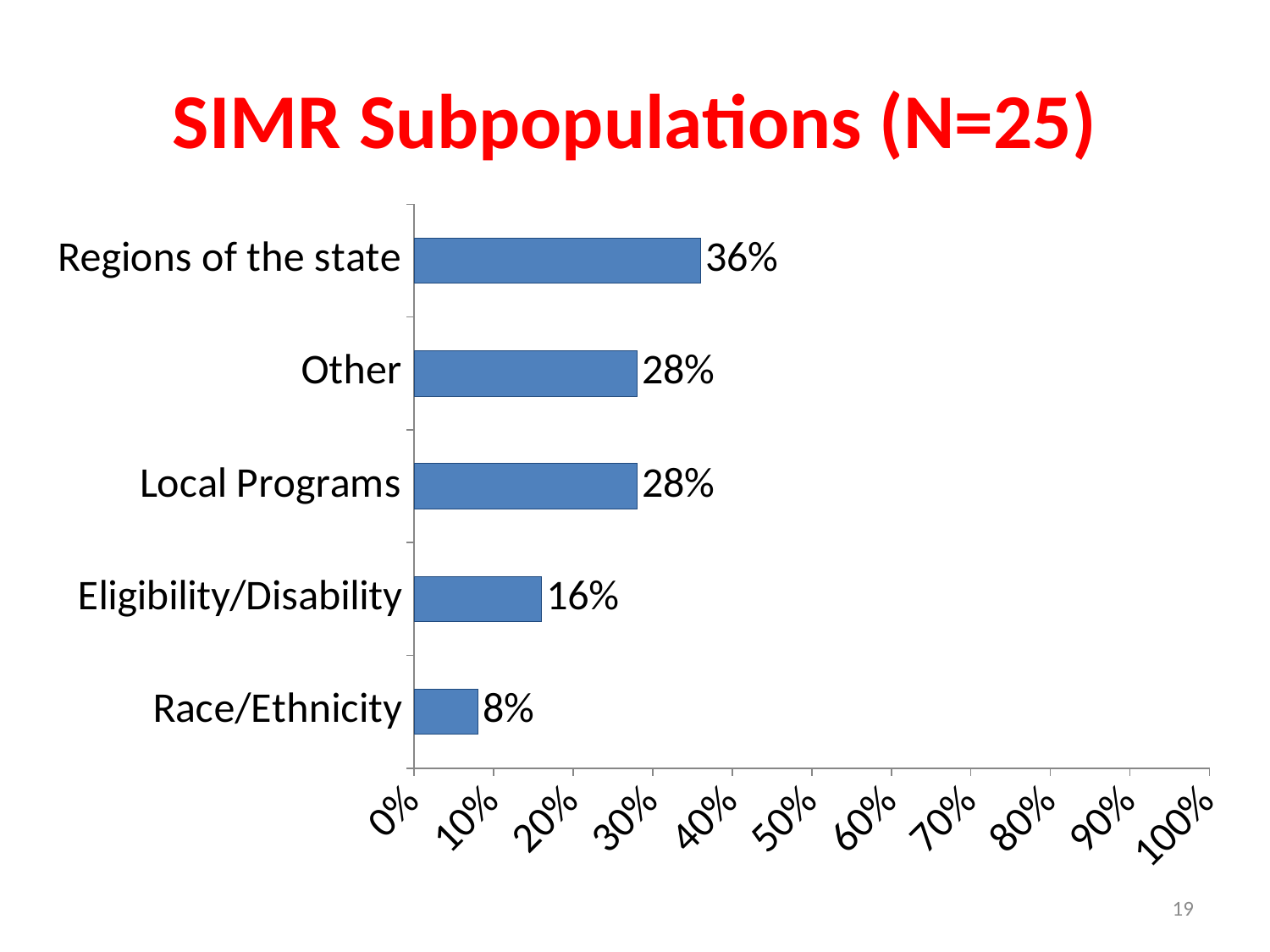
What is the value for Race/Ethnicity? 8% Which category has the highest value? Regions of the state What is the difference between the values for Other and Eligibility/Disability? 12% Is the value for Regions of the state greater or less than 30%? greater What is the value for Regions of the state? 36% What is the value for Eligibility/Disability? 16% What is the difference between the values for Regions of the state and Race/Ethnicity? 28% Which category has the lowest value? Race/Ethnicity What kind of chart is shown on the slide? Bar chart Which is larger, the value for Eligibility/Disability or the value for Race/Ethnicity? Eligibility/Disability What is the value for Local Programs? 28% How many categories are shown in the chart? 5